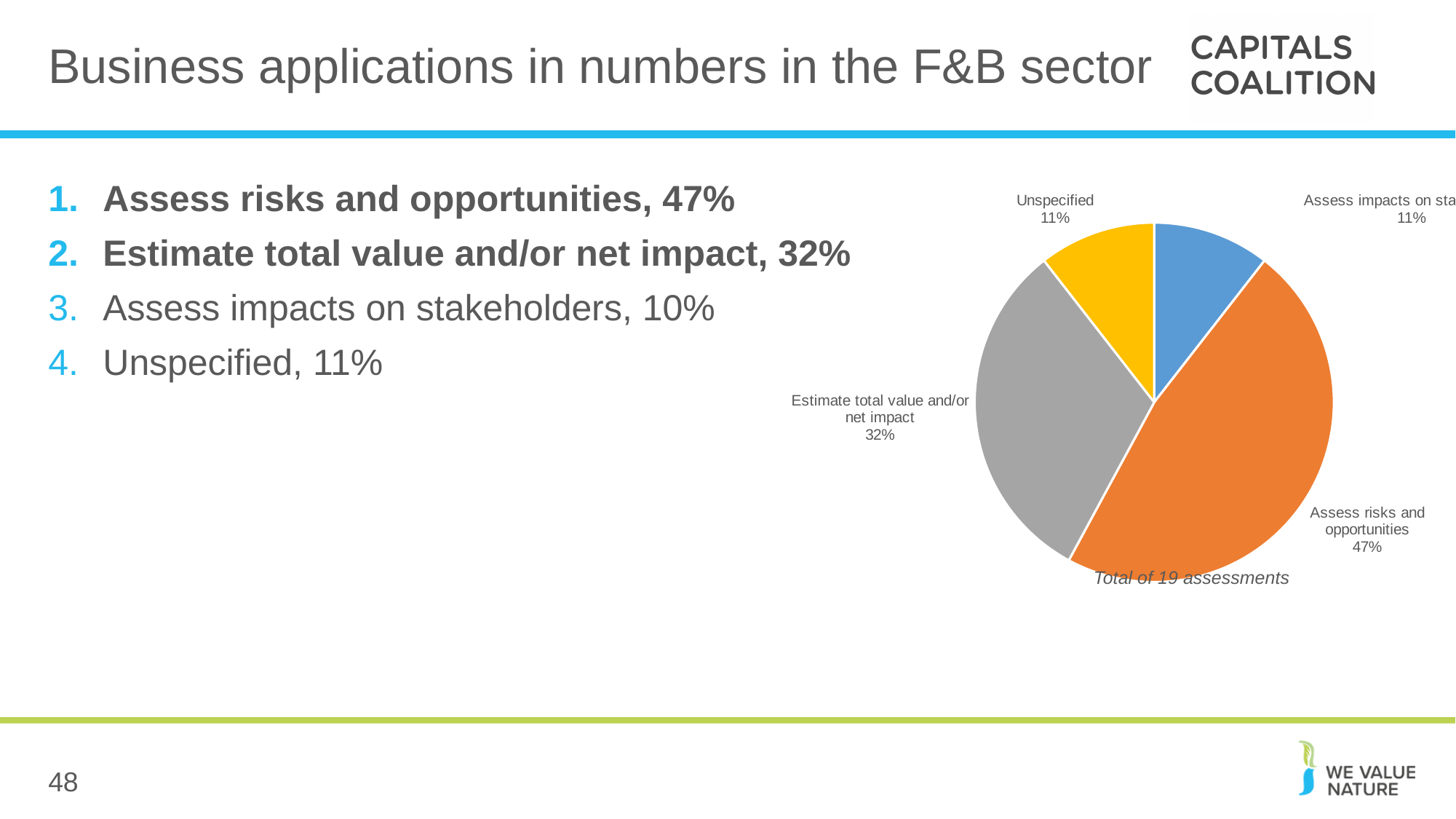
According to the note below the pie chart, how many assessments does the chart cover in total? 19 assessments Which slice of the pie chart is the largest? Assess risks and opportunities What colour is the Assess risks and opportunities slice in the pie chart? Orange Which is larger in the pie chart: Estimate total value and/or net impact or Unspecified? Estimate total value and/or net impact How many slices does the pie chart have? 4 What kind of chart is shown on the slide? Pie chart Which is larger in the pie chart: Assess risks and opportunities or Estimate total value and/or net impact? Assess risks and opportunities What percentage does the pie chart show for Assess risks and opportunities? 47% What percentage does the pie chart show for Estimate total value and/or net impact? 32% What percentage does the pie chart show for Unspecified? 11% By how many percentage points does Estimate total value and/or net impact exceed Unspecified in the pie chart? 21 percentage points By how many percentage points does Assess risks and opportunities exceed Estimate total value and/or net impact in the pie chart? 15 percentage points